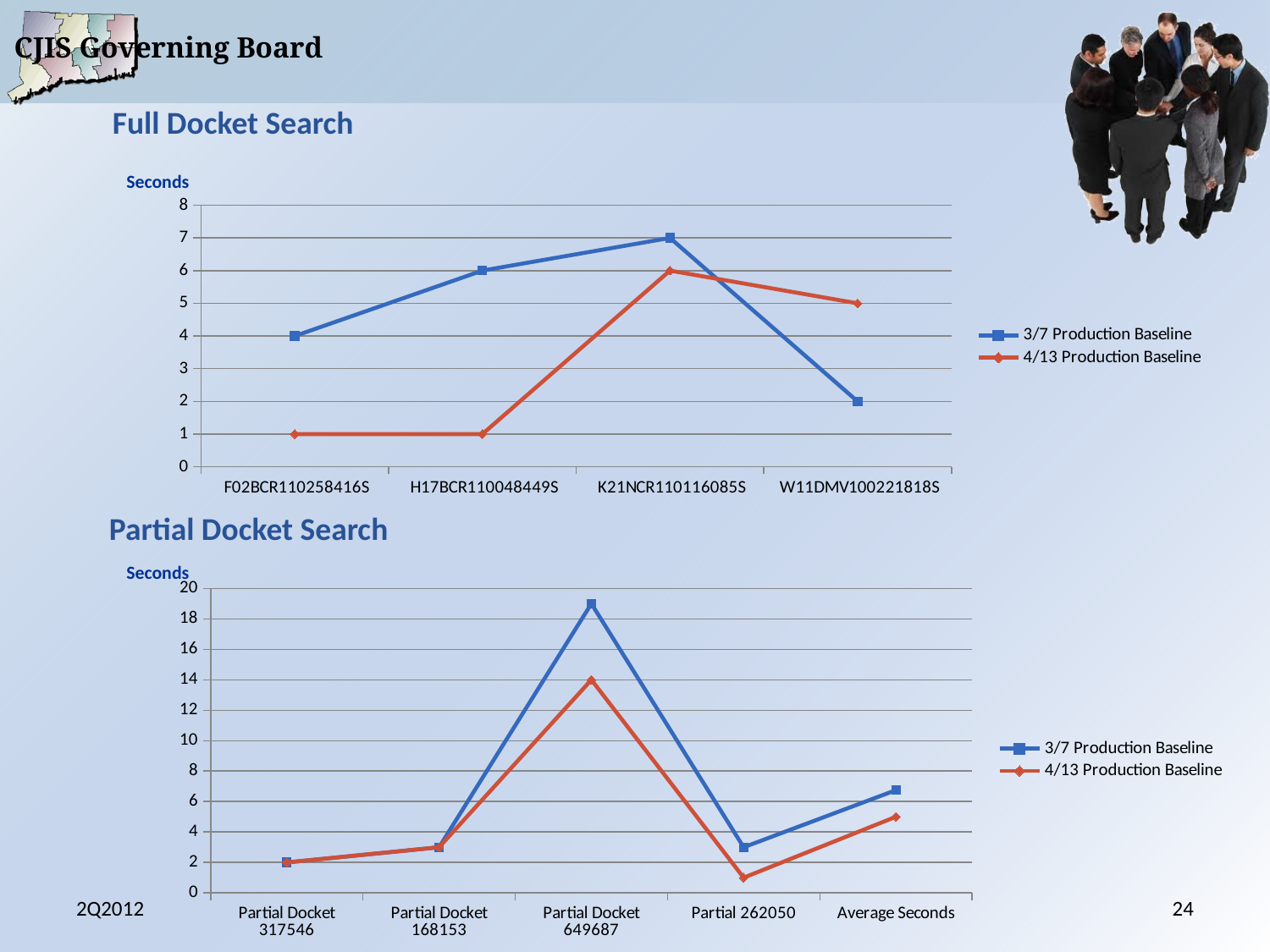
In the Partial Docket Search chart, what is the 4/13 Production Baseline value for Partial Docket 649687? 14 How many series does the legend of the Full Docket Search chart list? 2 In the Full Docket Search chart, what is the difference between the 3/7 and 4/13 Production Baseline values for H17BCR110048449S? 5 How many categories are shown on the x axis of the Partial Docket Search chart? 5 In the Full Docket Search chart, what is the 4/13 Production Baseline value for F02BCR110258416S? 1 In the Partial Docket Search chart, is the 3/7 Production Baseline value for Partial Docket 649687 greater or less than 18? greater In the Partial Docket Search chart, which category has the lowest 4/13 Production Baseline value? Partial 262050 In the Full Docket Search chart, which series has the larger value for W11DMV100221818S, 3/7 Production Baseline or 4/13 Production Baseline? 4/13 Production Baseline In the Full Docket Search chart, which docket has the highest 3/7 Production Baseline value? K21NCR110116085S In the Full Docket Search chart, what is the 4/13 Production Baseline value for W11DMV100221818S? 5 In the Full Docket Search chart, what is the 3/7 Production Baseline value for K21NCR110116085S? 7 What kind of chart is the Partial Docket Search chart? Line chart